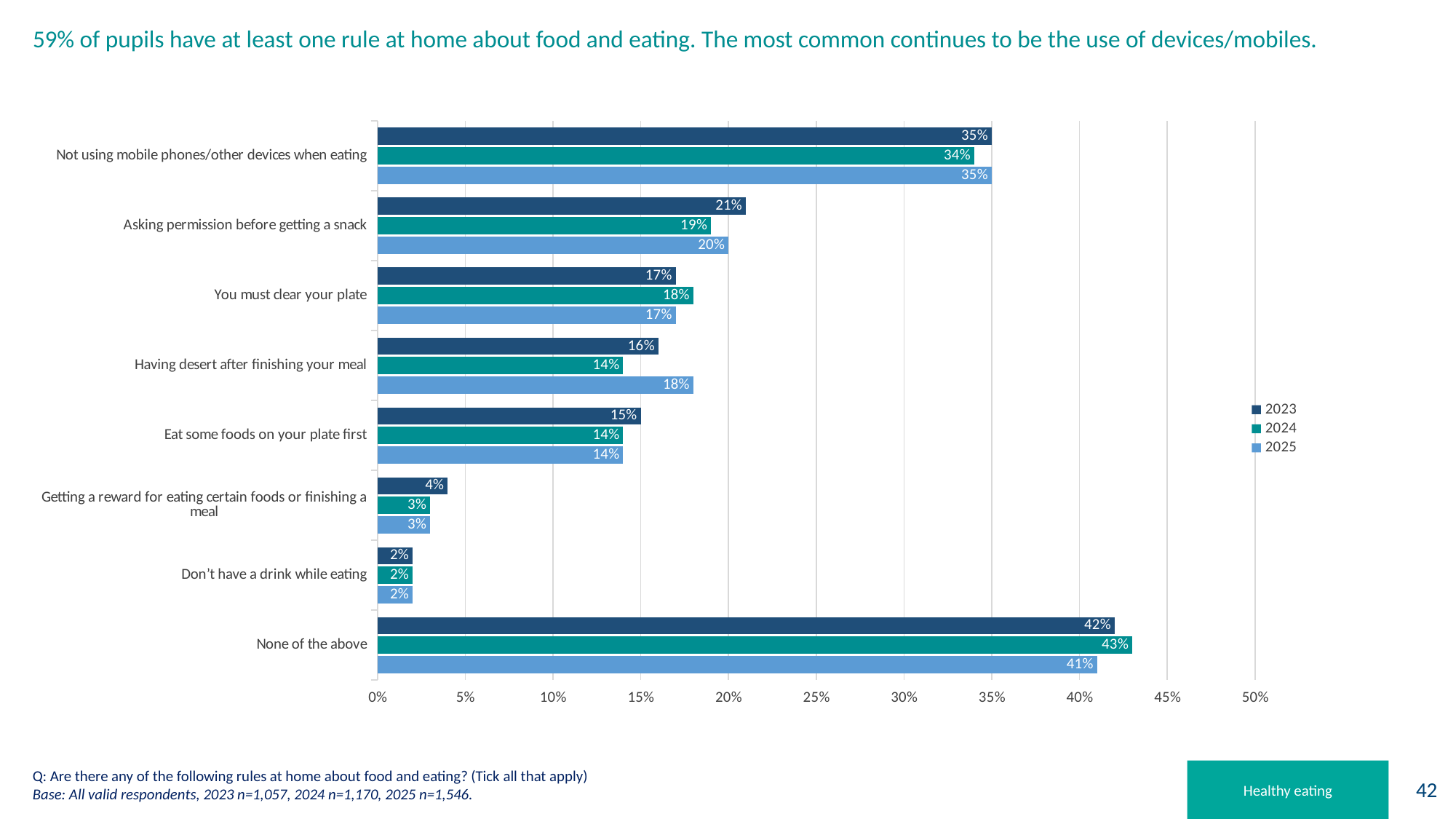
Which category has the highest value for the 2024 series? None of the above Is the 2023 value for 'None of the above' greater or less than 40%? greater Which years are listed in the chart legend? 2023, 2024, 2025 What is the 2023 value for 'Having desert after finishing your meal'? 16% What percentage of pupils in 2025 reported the rule 'Not using mobile phones/other devices when eating'? 35% How many series does the legend list? 3 What is the difference between the 2025 and 2024 values for 'Having desert after finishing your meal'? 4 percentage points What is the 2024 value for 'Asking permission before getting a snack'? 19% What kind of chart is shown on the slide? Bar chart Which category has the lowest value for the 2025 series? Don't have a drink while eating How many categories are shown on the chart? 8 Which is larger for 'Asking permission before getting a snack': the 2023 value or the 2025 value? 2023